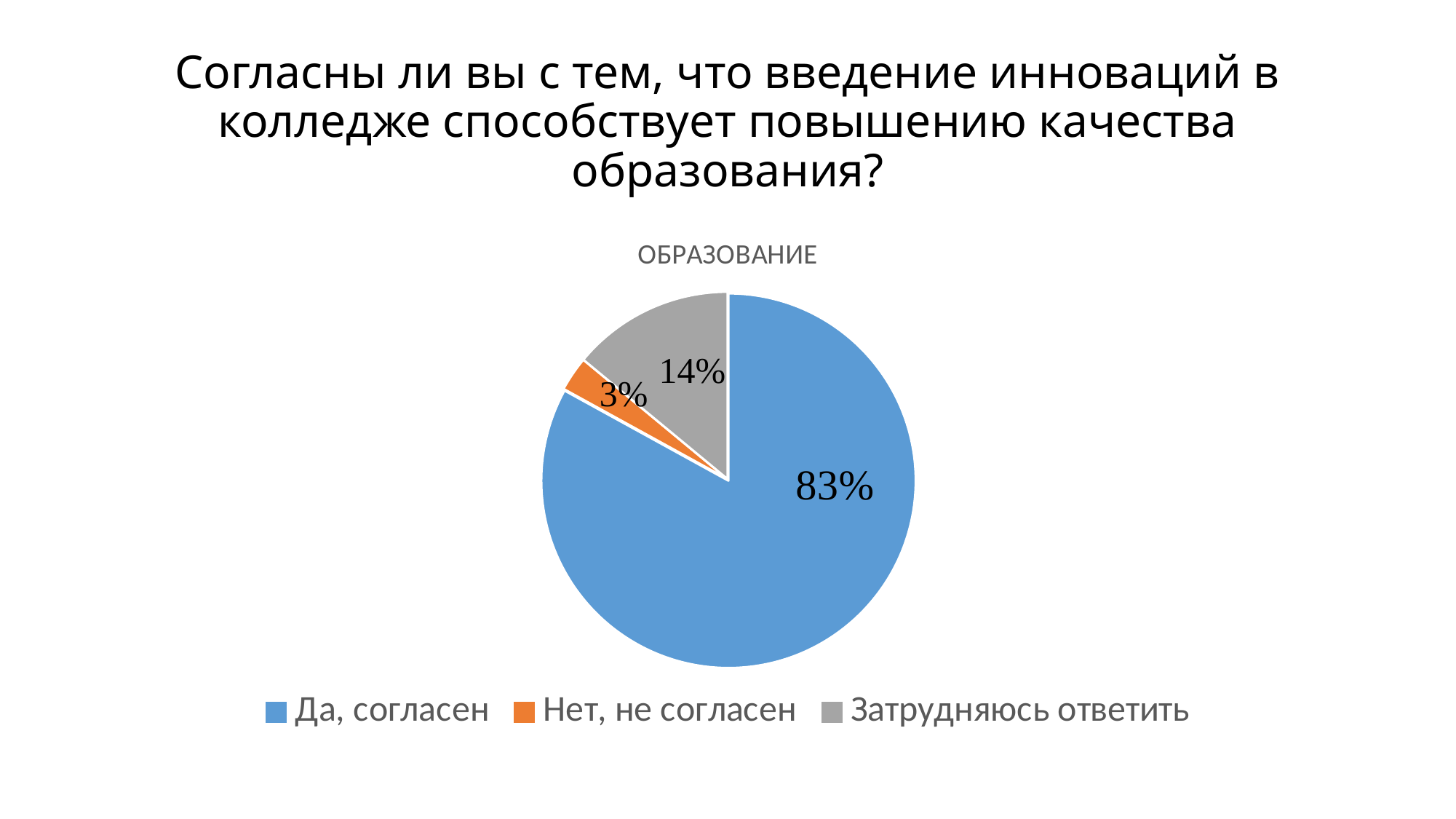
Which category has the largest slice of the pie? Да, согласен What share of the pie does "Да, согласен" take? 83% What is the difference in percentage points between "Затрудняюсь ответить" and "Нет, не согласен"? 11 Which category has the smallest slice of the pie? Нет, не согласен What is the difference in percentage points between "Да, согласен" and "Затрудняюсь ответить"? 69 What colour is the slice for "Нет, не согласен"? orange What is the title of the chart? ОБРАЗОВАНИЕ Which is larger: the share for "Затрудняюсь ответить" or the share for "Нет, не согласен"? Затрудняюсь ответить What kind of chart is shown on the slide? pie chart What share of the pie does "Нет, не согласен" take? 3% How many categories does the pie chart have? 3 What share of the pie does "Затрудняюсь ответить" take? 14%